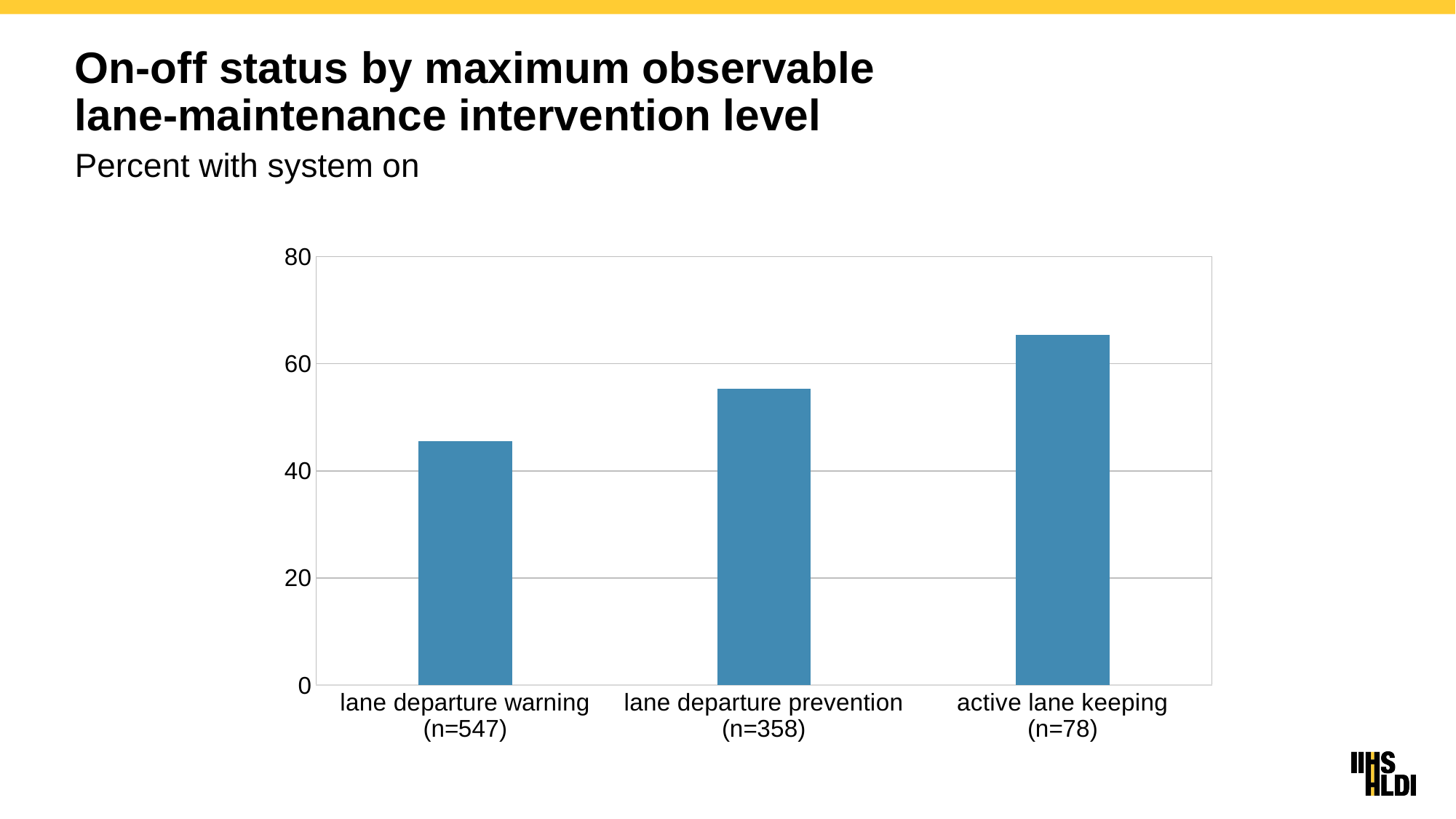
How many categories are plotted in the chart? 3 Is the value for lane departure prevention greater or less than 60? less What kind of chart is shown on the slide? bar chart What does the subtitle say the chart measures? Percent with system on Which category has the lowest percent with system on? lane departure warning Which has a lower percent with system on: lane departure warning or lane departure prevention? lane departure warning Is the value for lane departure warning greater or less than 40? greater Do the values rise or fall moving from lane departure warning to active lane keeping along the x axis? rise Which has a higher percent with system on: lane departure prevention or active lane keeping? active lane keeping What is the sample size (n) shown for the active lane keeping category? n=78 Is the value for active lane keeping greater or less than 60? greater Which category has the highest percent with system on? active lane keeping